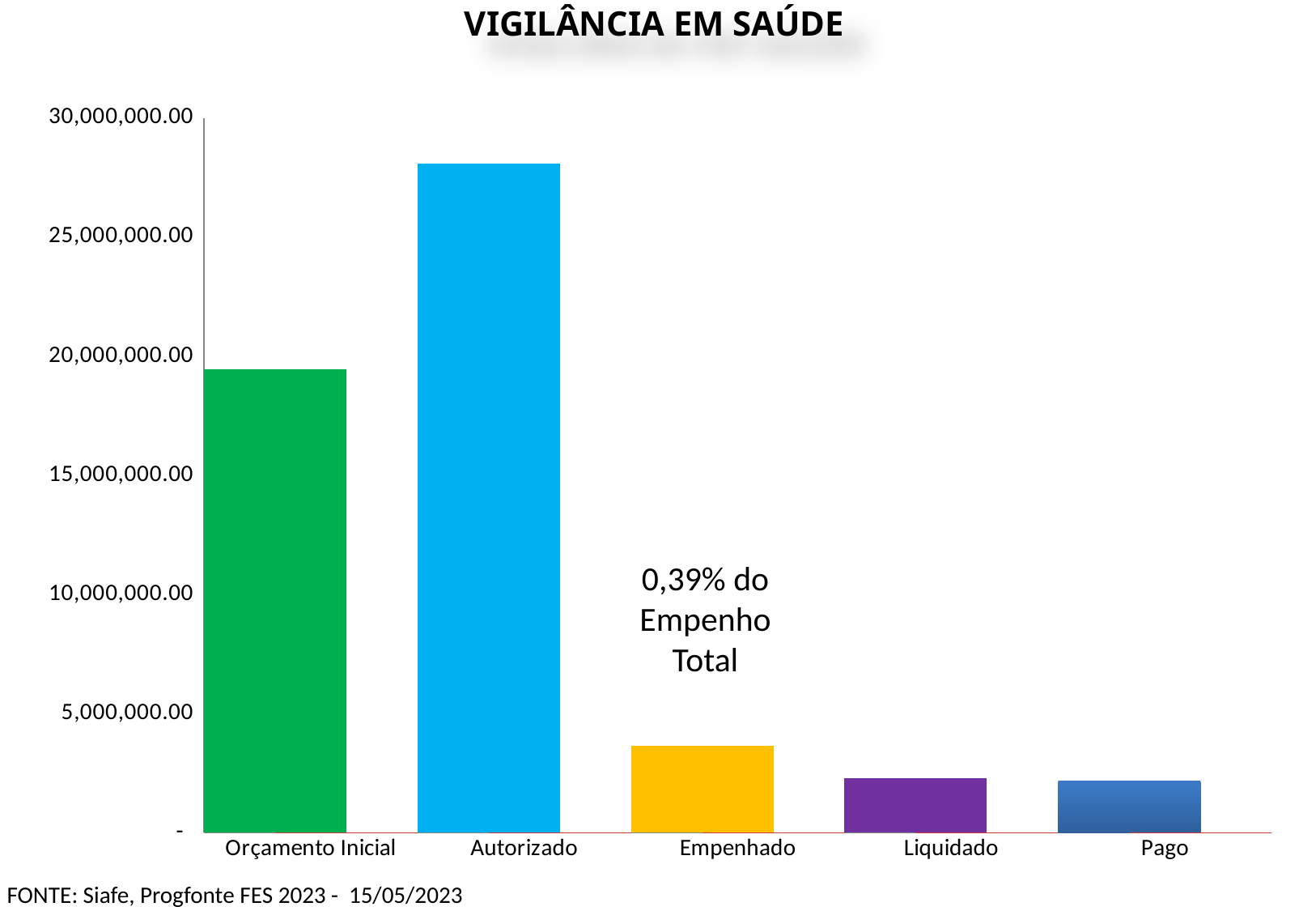
Is the value for Liquidado greater or less than 5,000,000.00? less Do the values rise or fall from Autorizado to Pago along the x axis? fall What is the title of the chart? VIGILÂNCIA EM SAÚDE What kind of chart is shown on the slide? bar chart Which is larger, the value for Empenhado or the value for Pago? Empenhado Which category has the highest value? Autorizado How many categories are shown on the x axis of the chart? 5 Which is larger, the value for Autorizado or the value for Orçamento Inicial? Autorizado Is the value for Empenhado greater or less than 5,000,000.00? less What text annotation is printed above the Empenhado bar? 0,39% do Empenho Total Is the value for Orçamento Inicial greater or less than 20,000,000.00? less